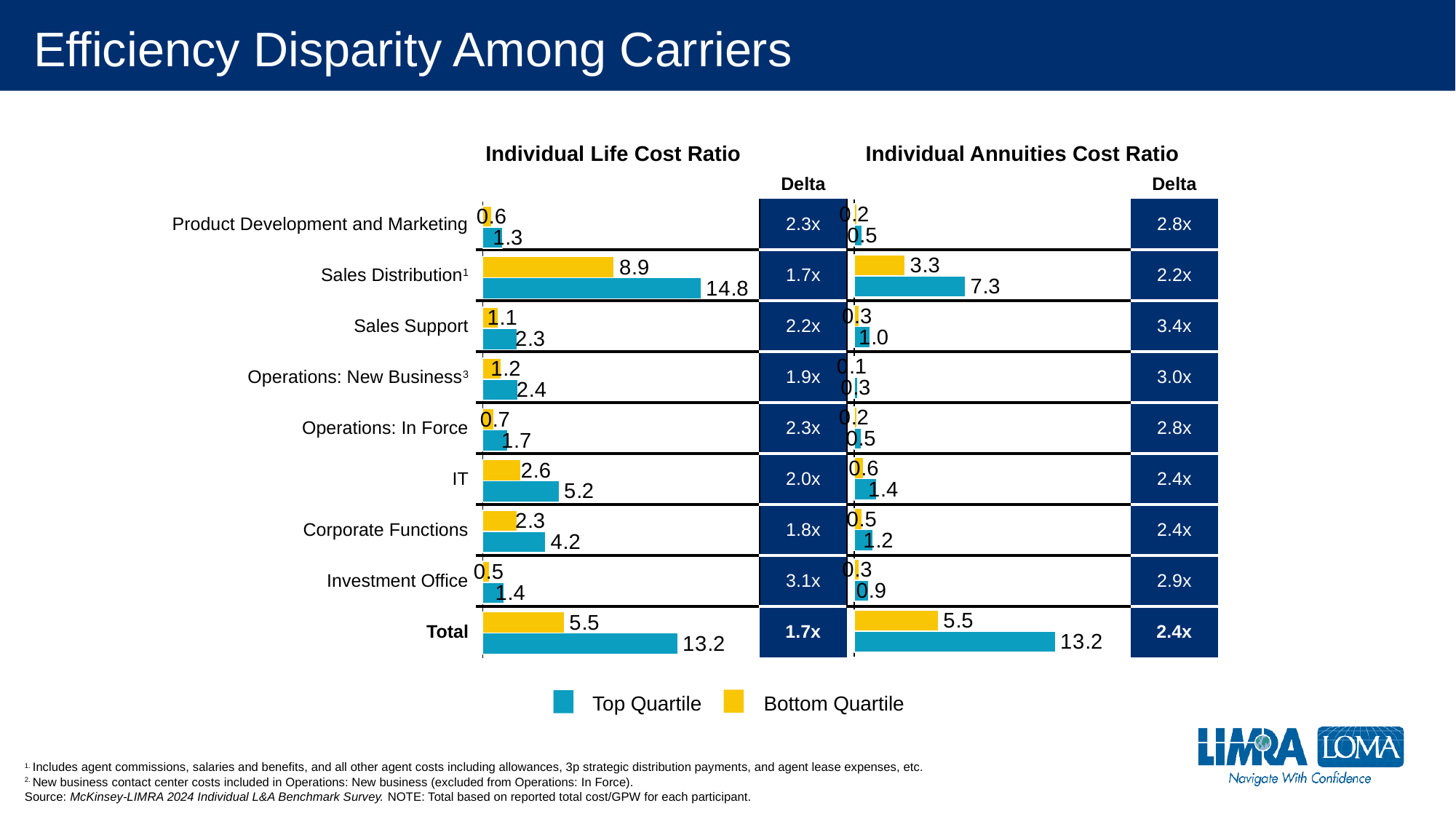
In the Individual Annuities Cost Ratio chart, which is larger: the Top Quartile value for IT or the Top Quartile value for Corporate Functions? IT In the Individual Life Cost Ratio chart, what is the Top Quartile value for Sales Distribution? 14.8 In the Individual Life Cost Ratio chart, which category has the lowest Bottom Quartile value? Investment Office In the Individual Annuities Cost Ratio chart, what is the difference between the Top Quartile and Bottom Quartile values for Total? 7.7 In the Individual Annuities Cost Ratio chart, what is the Bottom Quartile value for Sales Distribution? 3.3 How many series does the legend list? 2 In the Individual Life Cost Ratio chart, what is the difference between the Top Quartile and Bottom Quartile values for Corporate Functions? 1.9 How many categories (including Total) are shown in the Individual Life Cost Ratio chart? 9 What type of chart is used for the Individual Life Cost Ratio? Bar chart In the Individual Life Cost Ratio chart, what is the Top Quartile value for IT? 5.2 In the Individual Life Cost Ratio chart, which category has the highest Top Quartile value? Sales Distribution In the Individual Annuities Cost Ratio chart, what is the Delta shown for Sales Support? 3.4x